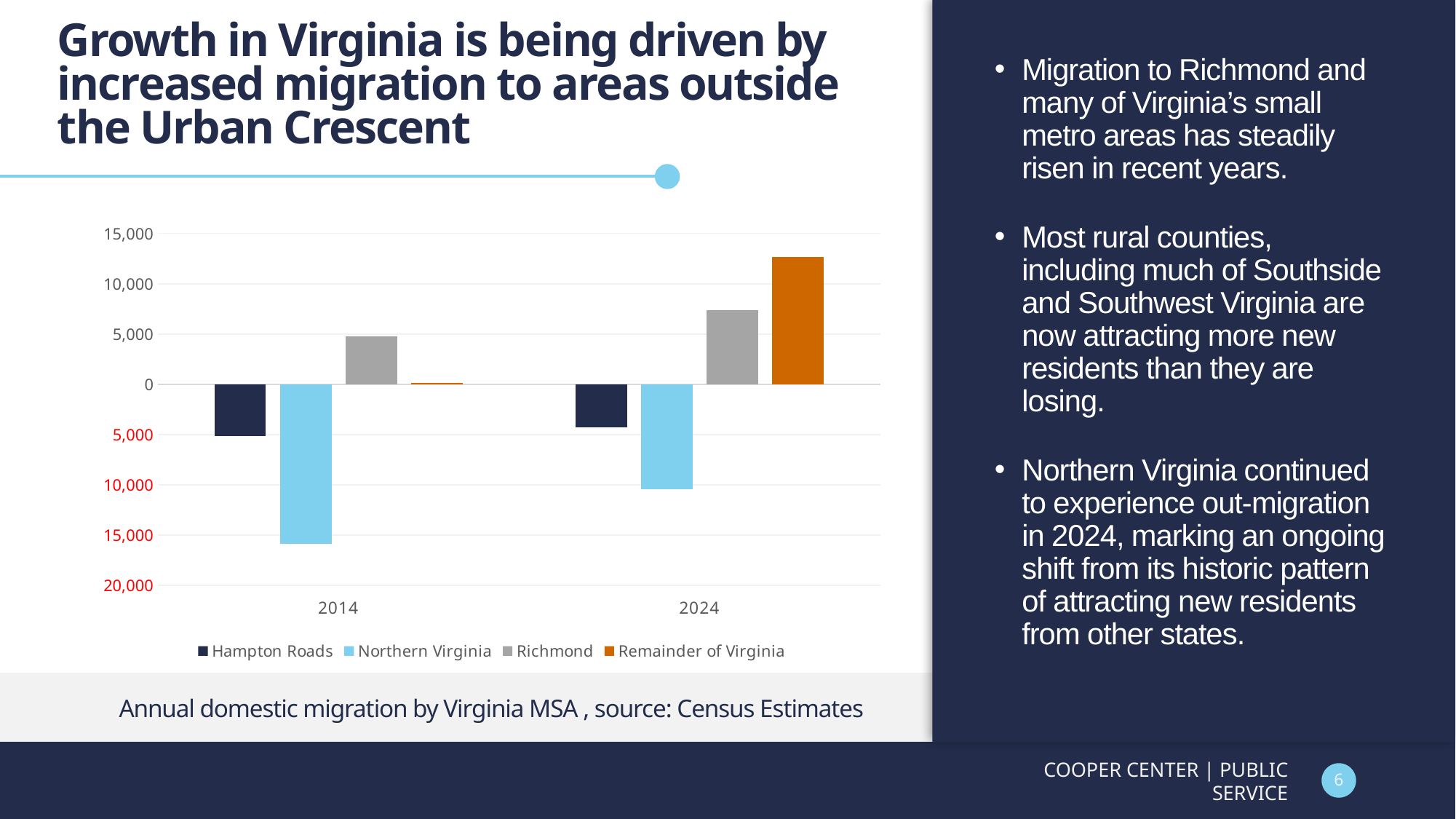
Is the value for Richmond in 2024 greater or less than 5,000? greater Does the value for Remainder of Virginia rise or fall from 2014 to 2024? Rise Which year has the larger value for Richmond, 2014 or 2024? 2024 What kind of chart is shown on the slide? Bar chart Which series has the lowest (most negative) bar in the chart? Northern Virginia (2014) Which series is shown in orange in the chart legend? Remainder of Virginia How many series does the chart legend list? 4 How many year categories are shown on the x axis of the chart? 2 Which series has the highest bar in the chart? Remainder of Virginia (2024) Which year has the larger value for Remainder of Virginia, 2014 or 2024? 2024 Is the value for Remainder of Virginia in 2024 greater or less than 10,000? greater Is the value for Richmond in 2014 greater or less than 10,000? less